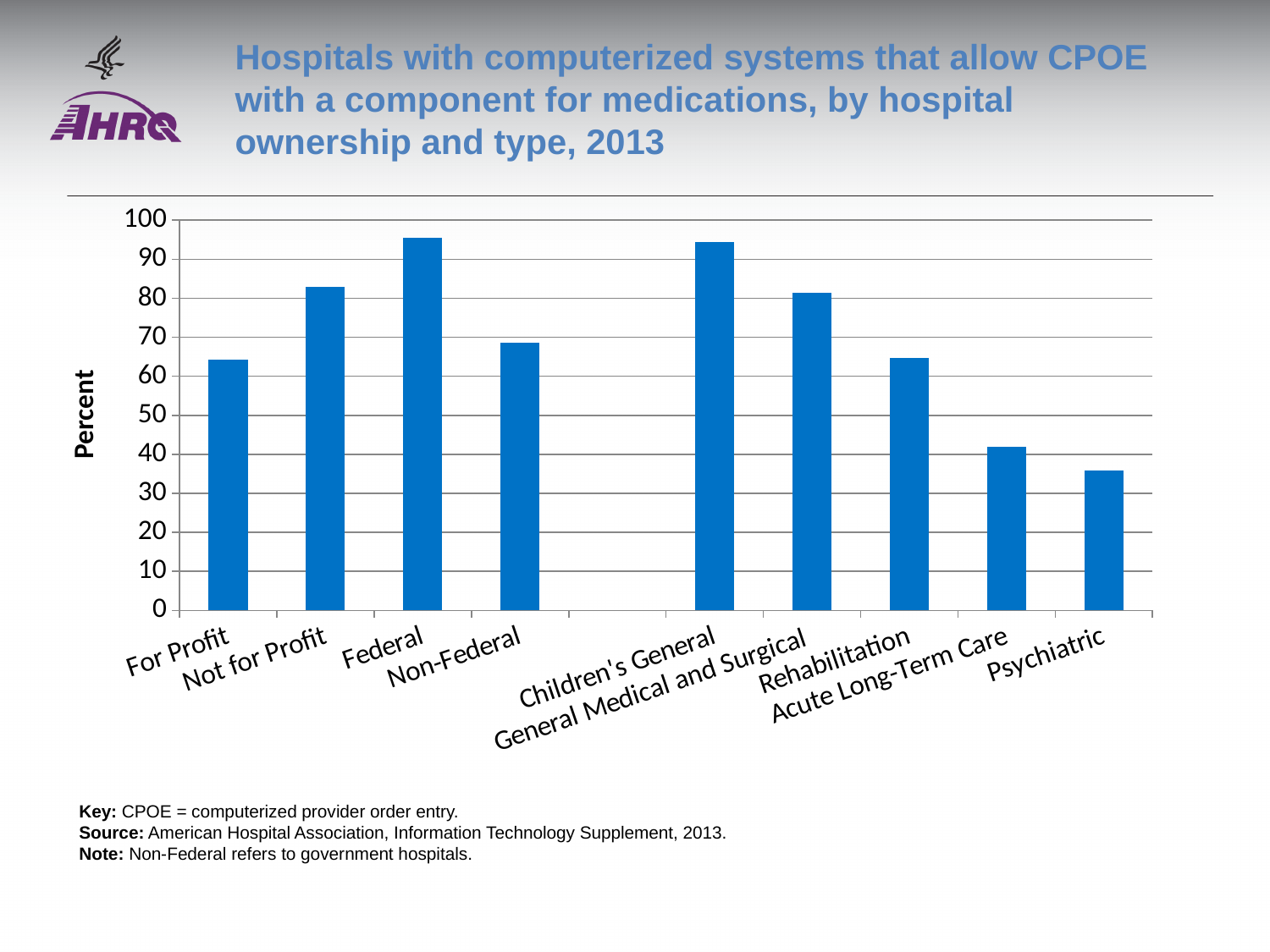
How many hospital categories are plotted in the chart? 9 Which has a higher percentage, Children's General or Rehabilitation hospitals? Children's General Is the value for Acute Long-Term Care hospitals greater or less than 50? less Is the value for Psychiatric hospitals greater or less than 40? less What is the label on the vertical axis of the chart? Percent Is the value for For Profit hospitals greater or less than 60? greater What kind of chart is shown on the slide? Bar chart Which hospital category has the lowest percentage in the chart? Psychiatric Which has a higher percentage, Federal or Non-Federal hospitals? Federal Which has a higher percentage, For Profit or Not for Profit hospitals? Not for Profit